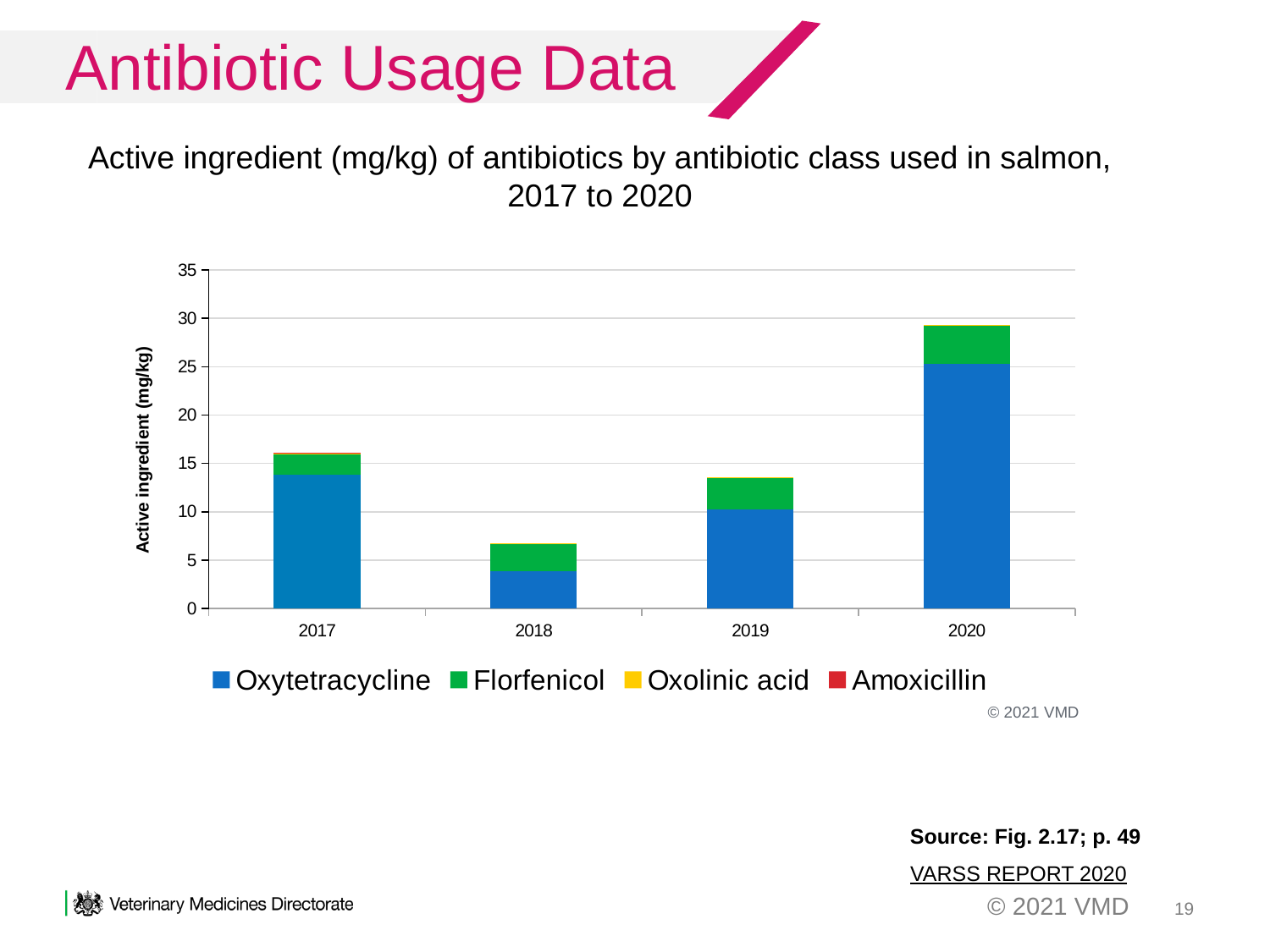
Is the Oxytetracycline value for 2019 greater or less than 15 mg/kg? less Is the total active ingredient for 2018 greater or less than 10 mg/kg? less How many years are shown along the x axis of the chart? 4 Which antibiotic class is shown in green in the chart legend? Florfenicol What is the label on the y axis of the chart? Active ingredient (mg/kg) Which antibiotic class makes up the largest part of each bar? Oxytetracycline How many series does the chart legend list? 4 Which year has the larger total active ingredient, 2017 or 2019? 2017 Which year has the highest total active ingredient (mg/kg)? 2020 Is the total active ingredient for 2020 greater or less than 25 mg/kg? greater Which year has the lowest total active ingredient (mg/kg)? 2018 What kind of chart is shown on the slide? Stacked bar chart